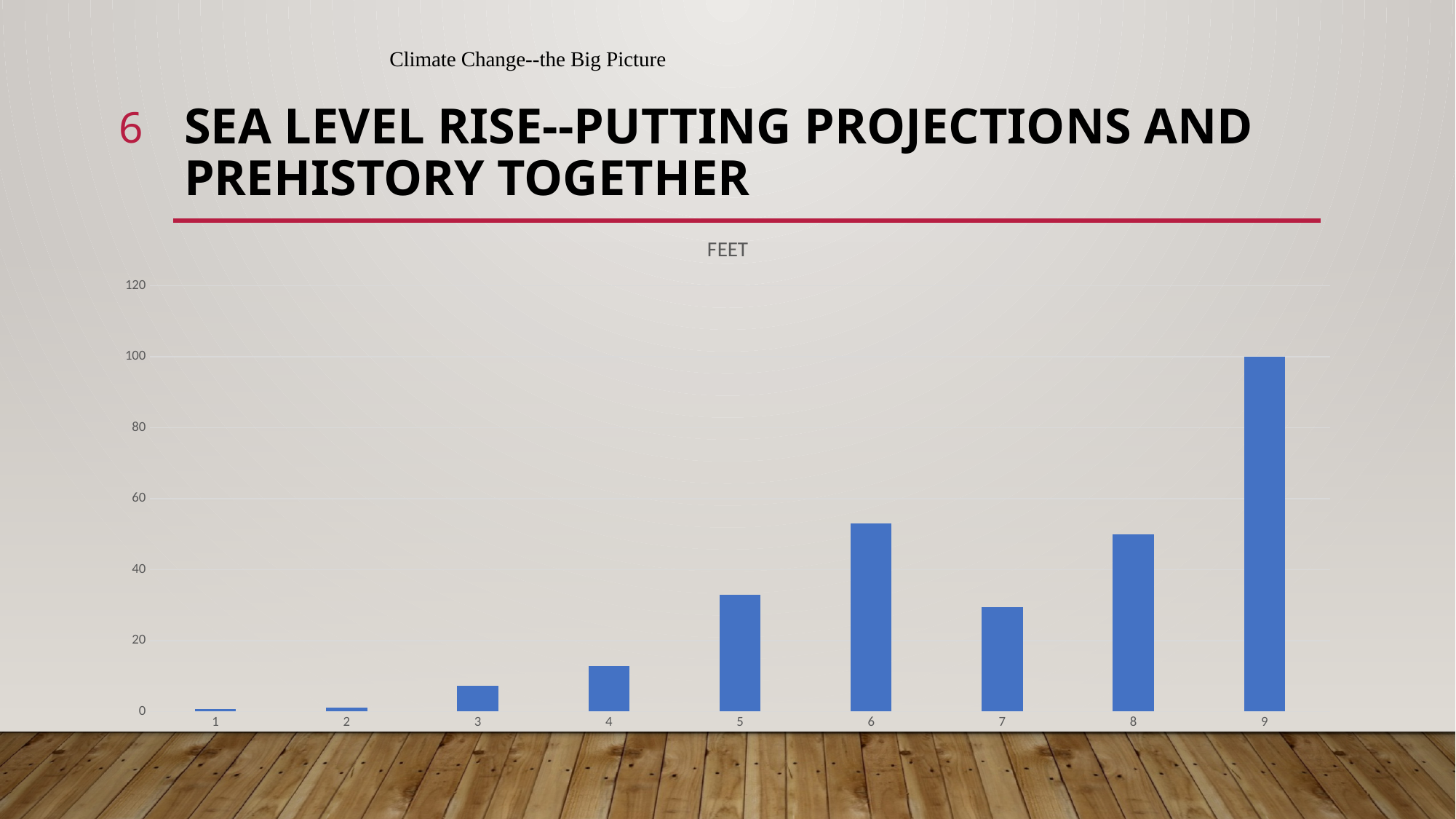
What is the value for category 9? 100 What kind of chart is shown on the slide? bar chart Is the value for category 8 greater or less than 40? greater Is the value for category 5 greater or less than 40? less What is the title of the chart? FEET Which is larger, the value for category 9 or the value for category 6? 9 Is the value for category 7 greater or less than 20? greater Do the values generally rise or fall from category 1 to category 9? rise Which category has the highest bar? 9 How many categories are plotted on the x axis? 9